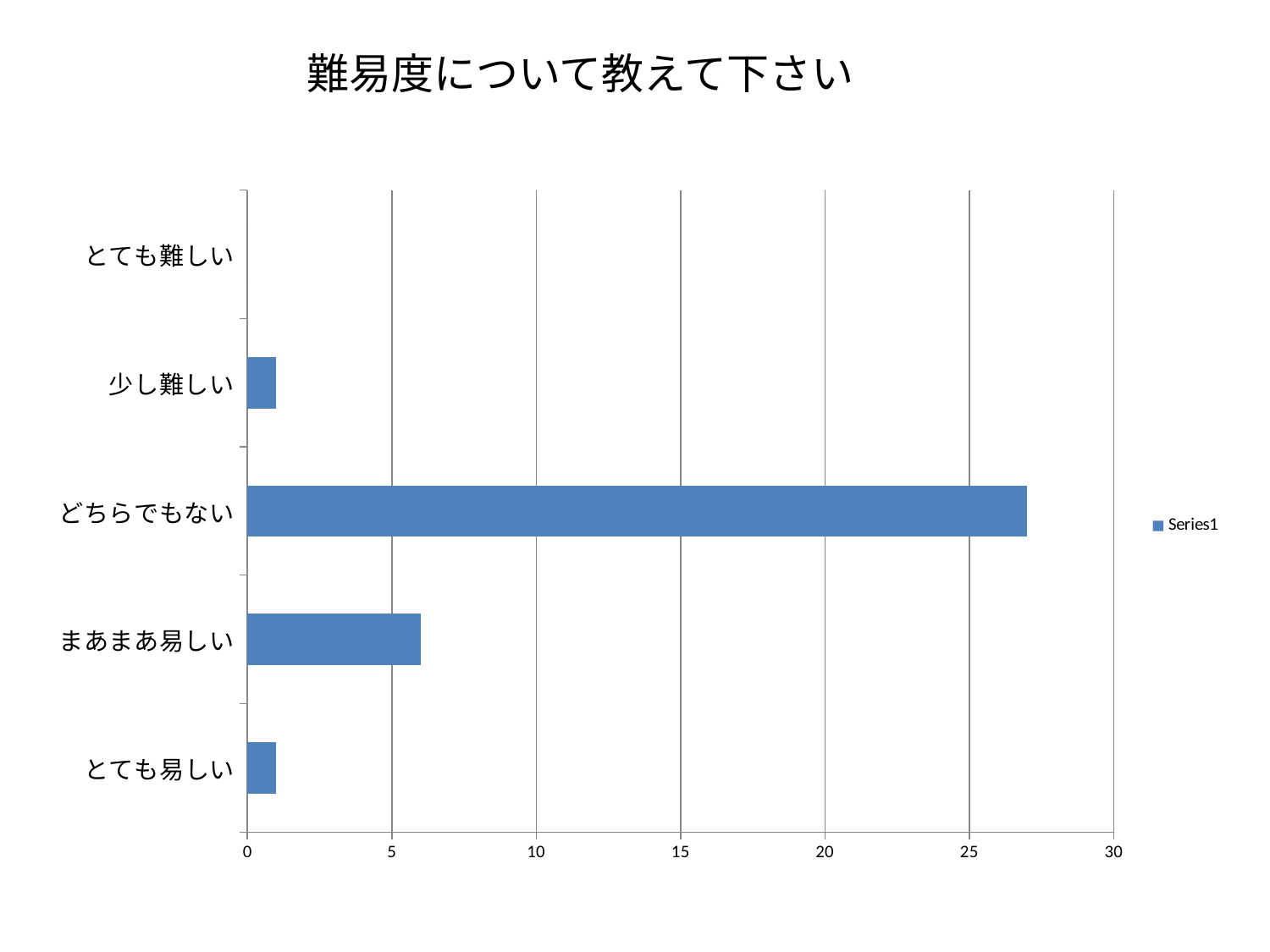
Is the value for とても易しい greater or less than 5? less Which category has the lowest value? とても難しい Which category has the highest value? どちらでもない Is the value for まあまあ易しい greater or less than 5? greater Is the value for 少し難しい greater or less than 5? less How many series does the legend list? 1 What is the name of the series shown in the legend? Series1 Which is larger, the value for まあまあ易しい or the value for 少し難しい? まあまあ易しい How many categories are shown on the chart? 5 What kind of chart is shown on the slide? bar chart What is the title of the chart? 難易度について教えて下さい